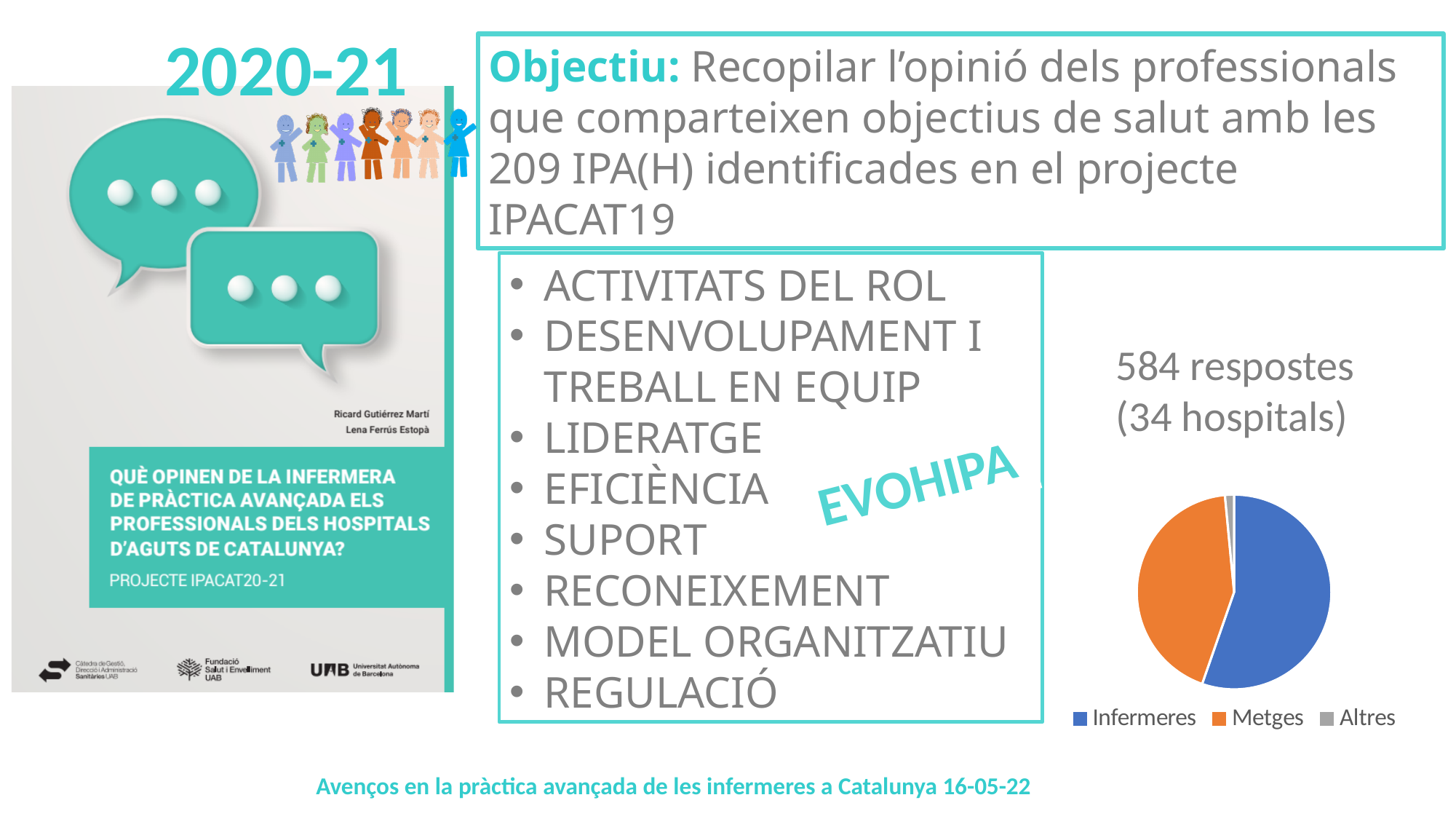
How many entries does the legend of the pie chart list? 3 What colour is the Metges slice in the pie chart? orange Which category has the largest slice in the pie chart? Infermeres Which category is shown in grey in the pie chart? Altres How many slices does the pie chart have? 3 Which slice is larger in the pie chart, Infermeres or Metges? Infermeres What kind of chart is shown on the slide? pie chart Which slice is larger in the pie chart, Metges or Altres? Metges Which category has the smallest slice in the pie chart? Altres